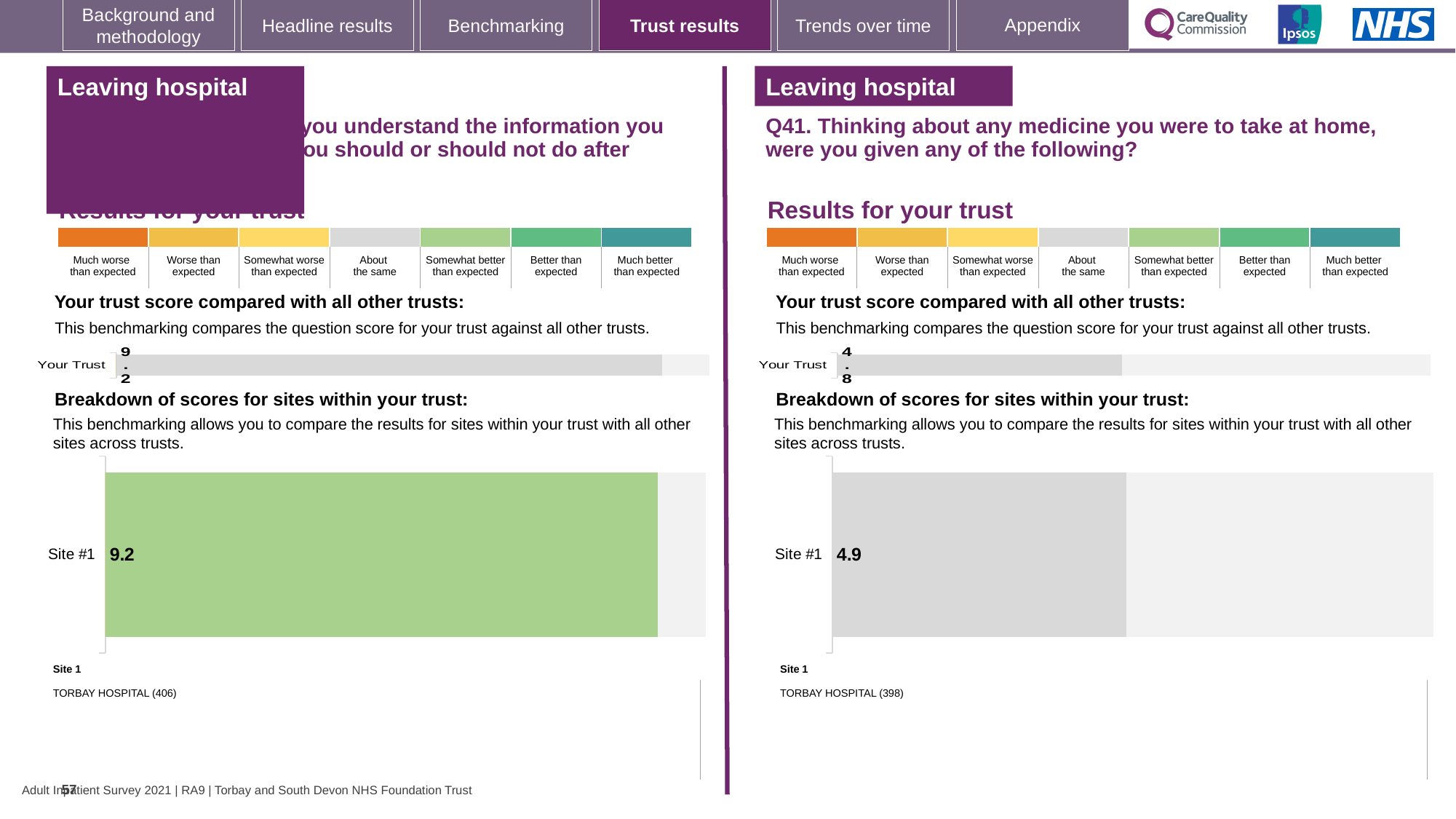
Which Site #1 score is larger: the one on the left half of the slide or the one on the right half (Q41)? Left half (9.2) On the right half of the slide (Q41), is the Site #1 score greater or less than 5? less What is the difference between the Site #1 score on the left half of the slide and the Site #1 score on the right half (Q41)? 4.3 On the right half of the slide (Q41), what is the score shown for Site #1 in the breakdown of scores chart? 4.9 Which site name is listed under Site 1 on the left half of the slide? TORBAY HOSPITAL (406) How many sites are shown in the breakdown of scores chart on the right half of the slide (Q41)? 1 On the left half of the slide, what is the score shown for Site #1 in the breakdown of scores chart? 9.2 What colour is the Site #1 bar in the breakdown chart on the left half of the slide? Green On the left half of the slide, what is the value shown for Your Trust in the trust score chart? 9.2 On the right half of the slide (Q41), what is the value shown for Your Trust in the trust score chart? 4.8 What kind of chart is used to show the Site #1 score on the left half of the slide? Bar chart What is the difference between the Your Trust score on the left half of the slide and the Your Trust score on the right half (Q41)? 4.4